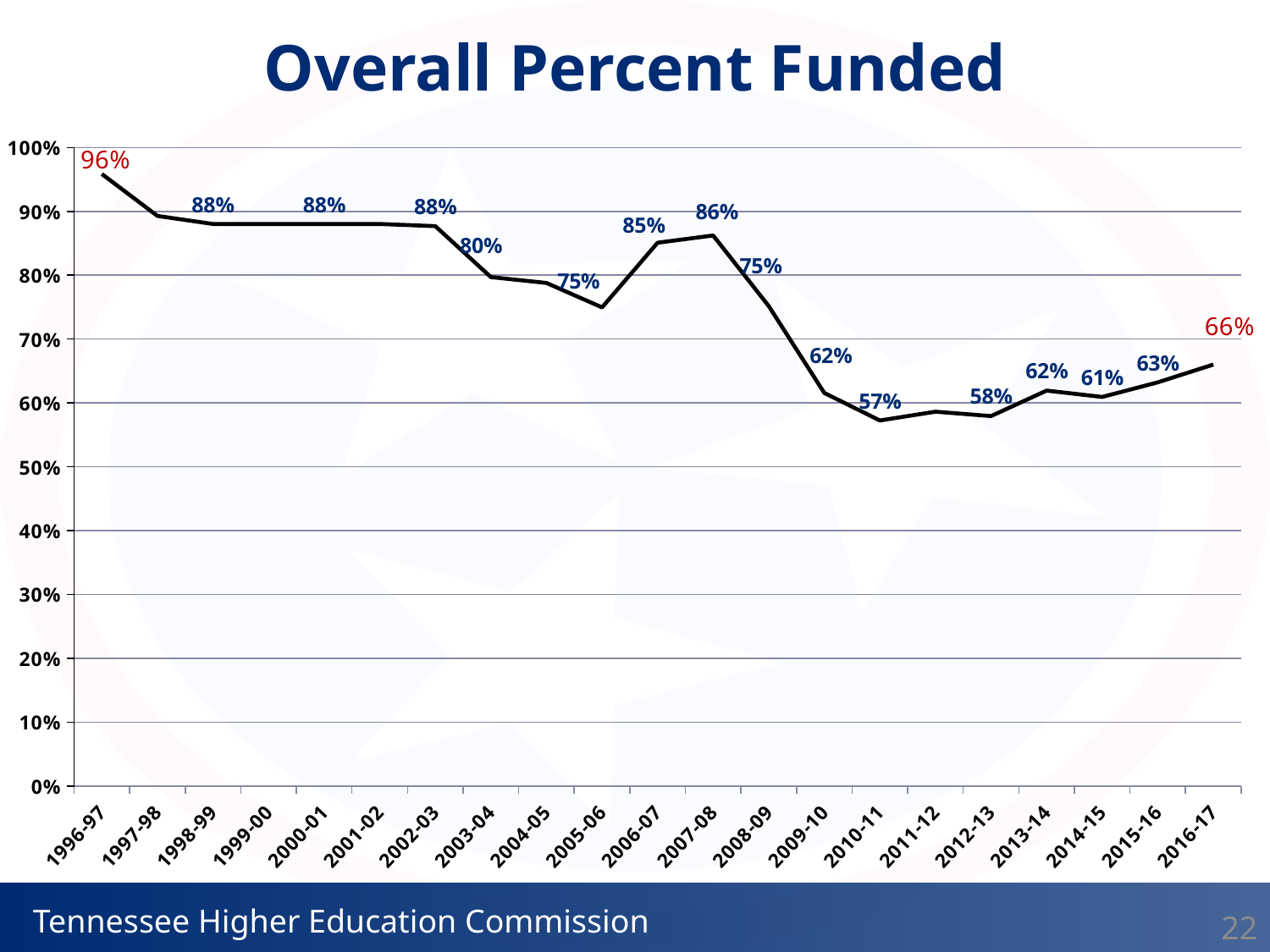
What is the title of the chart? Overall Percent Funded What is the overall percent funded for 2010-11? 57% What is the overall percent funded for 2007-08? 86% How many academic years are plotted on the x axis? 21 What type of chart is shown on the slide? Line chart What is the overall percent funded for 2016-17? 66% By how many percentage points did the overall percent funded fall from 1996-97 to 2016-17? 30 percentage points Which year has the lowest overall percent funded? 2010-11 Is the value for 1997-98 greater or less than 80%? greater What is the overall percent funded for 1996-97? 96% Which year has the highest overall percent funded? 1996-97 Which year has a higher overall percent funded, 2006-07 or 2009-10? 2006-07